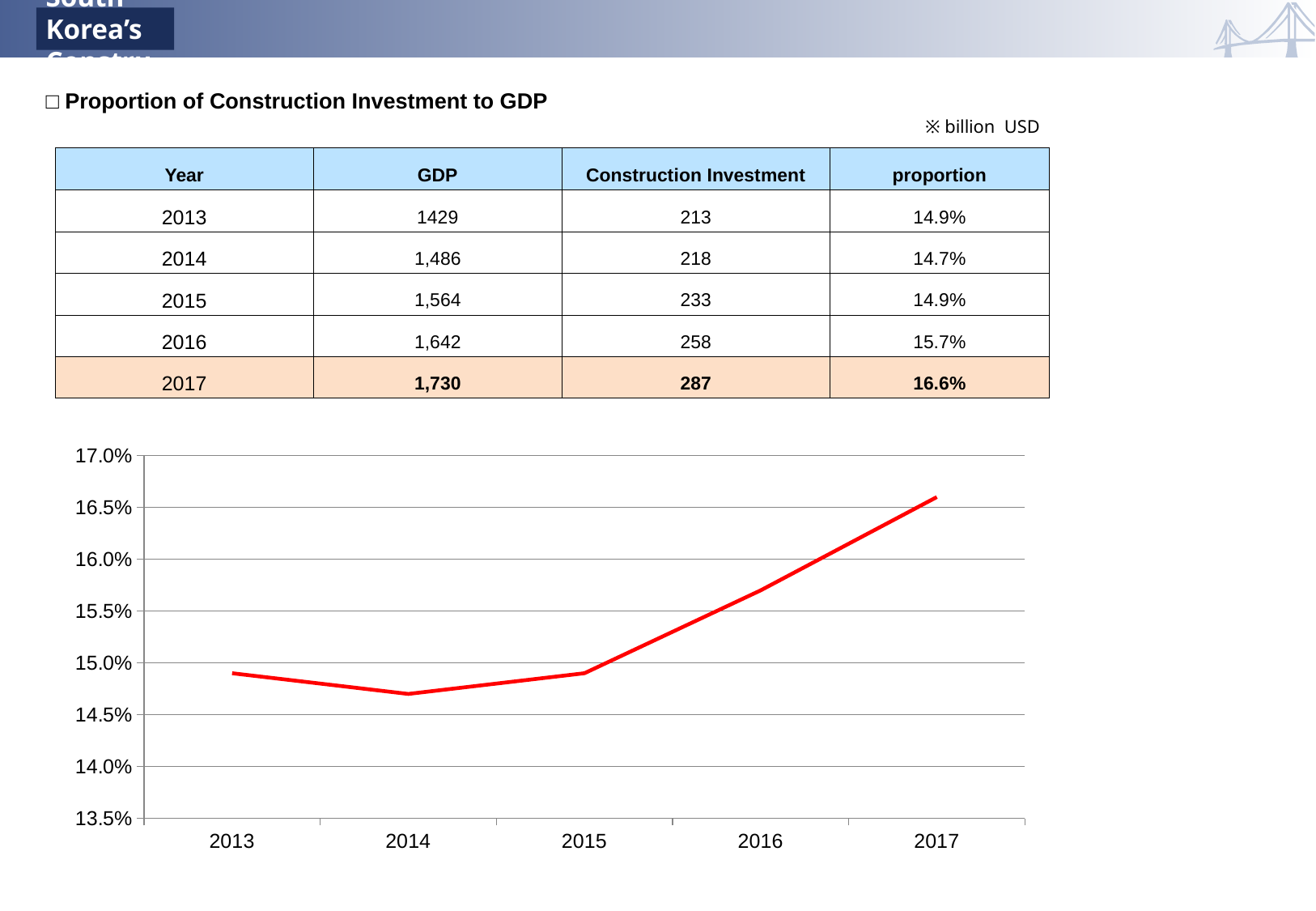
Is the proportion for 2017 greater or less than 16.5%? greater What is the proportion of construction investment to GDP for 2014, as printed on the slide? 14.7% Is the proportion for 2016 greater or less than 15.5%? greater Does the proportion rise or fall from 2015 to 2017 in the line chart? rise Which year has the highest proportion in the line chart? 2017 How many years are plotted on the x axis of the line chart? 5 What is the proportion of construction investment to GDP for 2017, as printed on the slide? 16.6% What kind of chart is shown on the slide? line chart What colour is the line in the chart? red Is the proportion for 2014 greater or less than 15.0%? less Which is larger, the proportion for 2016 or the proportion for 2015? 2016 Which year has the lowest proportion in the line chart? 2014